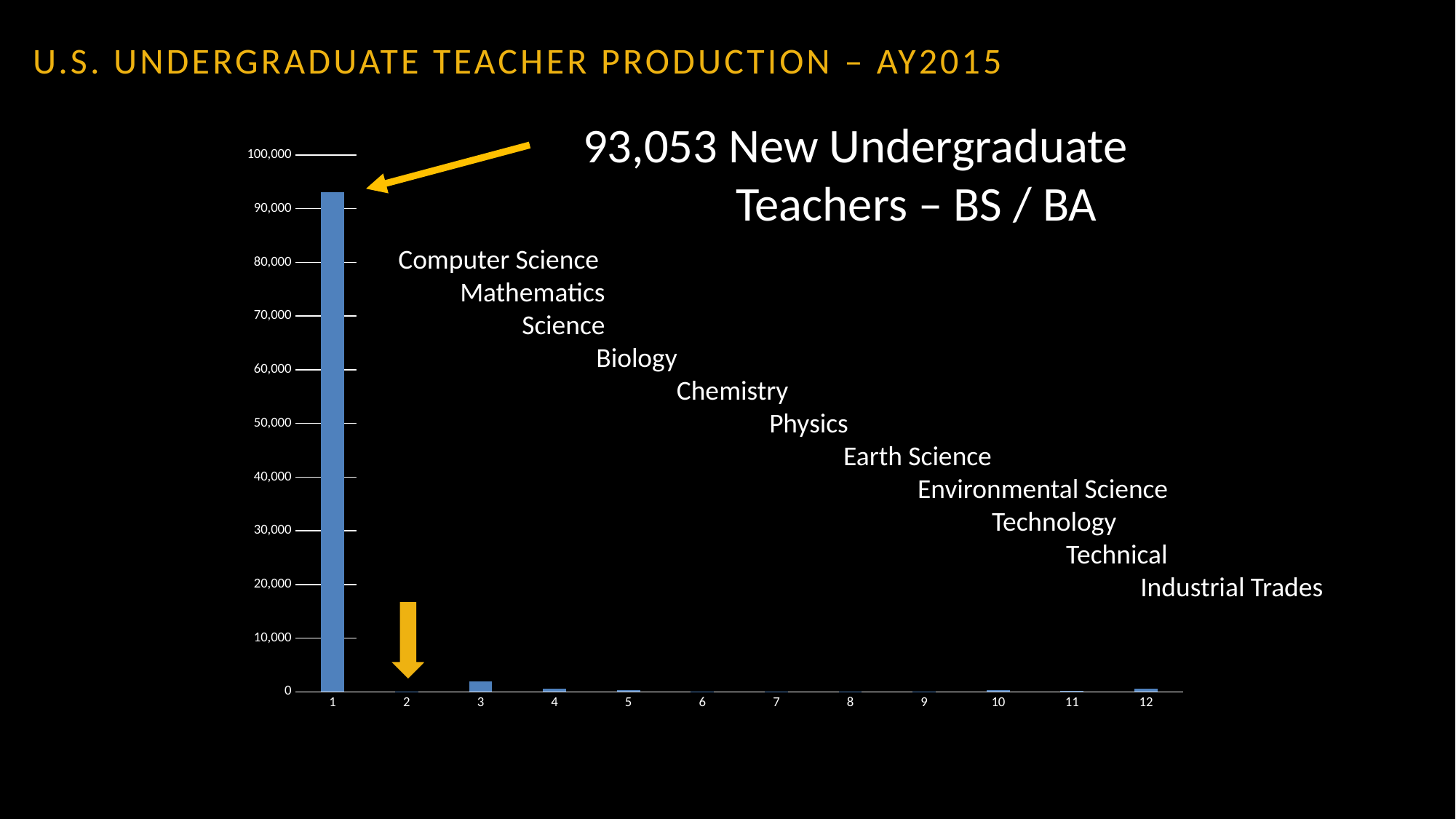
What kind of chart is shown on the slide? bar chart Is the value for category 3 greater or less than 10,000? less What is the highest tick value shown on the chart's vertical axis? 100,000 Which is larger, the value for category 1 or the value for category 2? category 1 What is the title of the slide containing the chart? U.S. Undergraduate Teacher Production – AY2015 What value does the annotation give for the tallest bar (category 1)? 93,053 Do the bar values generally rise or fall moving from category 1 to category 2 along the x axis? fall How many categories are shown on the x axis of the chart? 12 Which is larger, the value for category 3 or the value for category 4? category 3 Is the value for category 1 greater or less than 90,000? greater Is the value for category 12 greater or less than 10,000? less Which category has the highest bar in the chart? 1